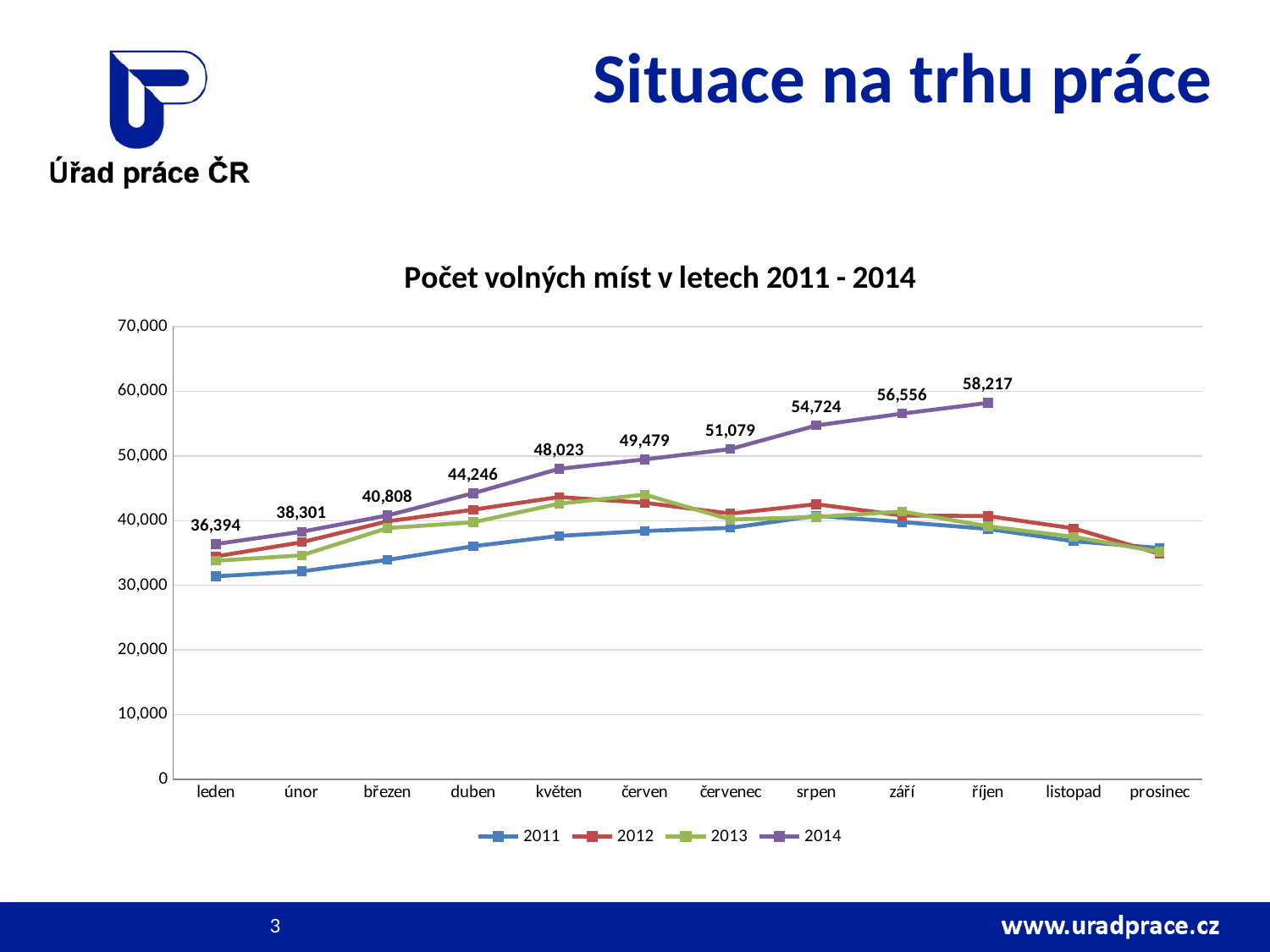
What is the value for 2014 in červenec? 51,079 What is the difference between the 2014 values for říjen and leden? 21,823 What is the difference between the 2014 values for září and srpen? 1,832 Is the value for 2011 in leden greater or less than 40,000? less Is the value for 2012 in srpen greater or less than 40,000? greater How many series does the legend list? 4 In which month does the 2014 series reach its highest labelled value? říjen In květen, which series has the larger value, 2014 or 2013? 2014 How many months are shown on the x axis? 12 What kind of chart is shown on the slide? line chart What is the value for 2014 in leden? 36,394 What is the value for 2014 in říjen? 58,217